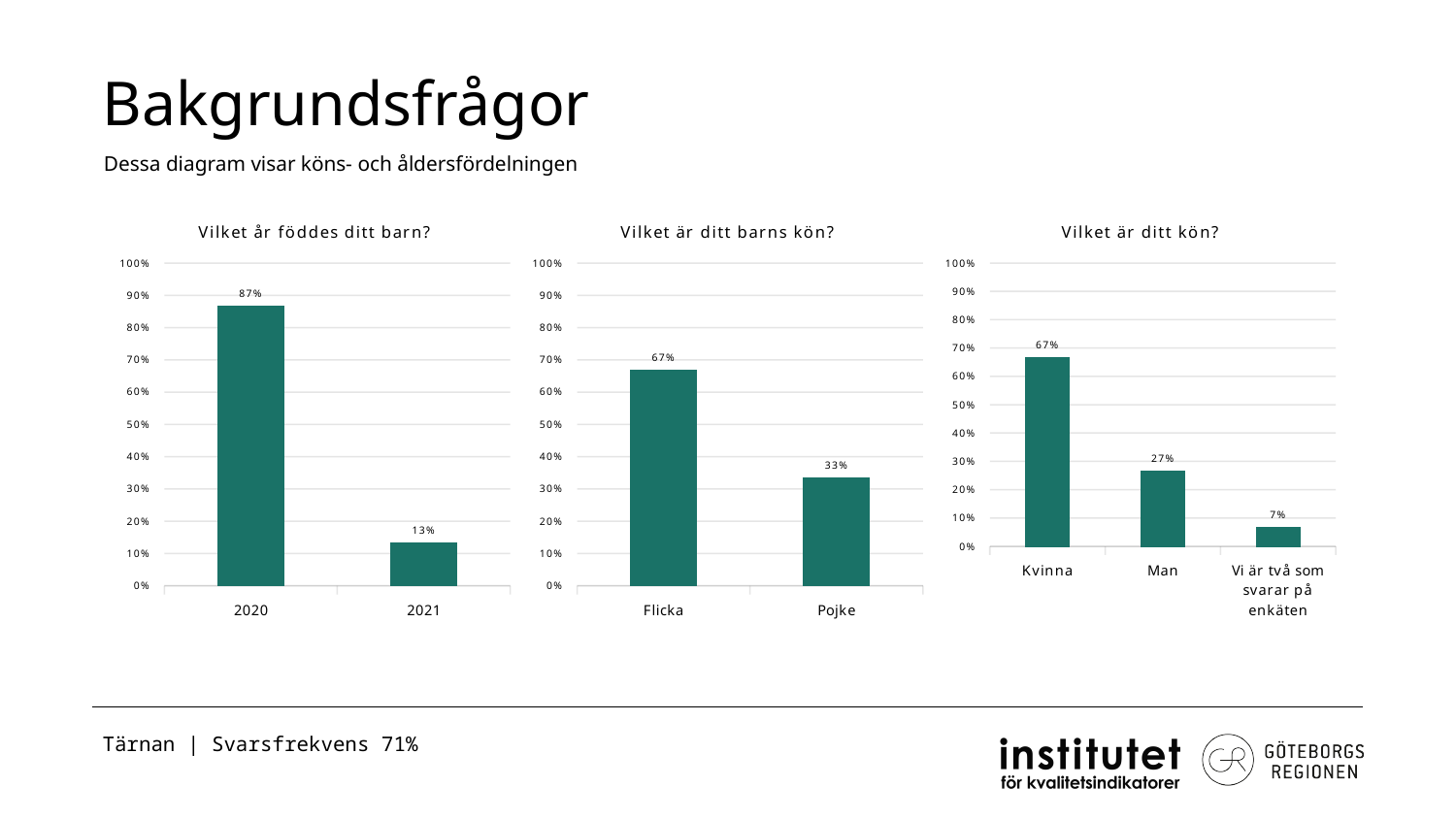
In the chart titled "Vilket är ditt barns kön?", what is the value for Flicka? 67% In the chart titled "Vilket år föddes ditt barn?", what is the value for 2021? 13% In the chart titled "Vilket är ditt kön?", which category has the lowest value? Vi är två som svarar på enkäten In the chart titled "Vilket är ditt kön?", which category has the highest value? Kvinna In the chart titled "Vilket är ditt barns kön?", what is the value for Pojke? 33% In the chart titled "Vilket år föddes ditt barn?", what is the value for 2020? 87% In the chart titled "Vilket är ditt barns kön?", which category has the higher value, Flicka or Pojke? Flicka In the chart titled "Vilket år föddes ditt barn?", what is the difference between the values for 2020 and 2021? 74% In the chart titled "Vilket är ditt kön?", what is the value for Man? 27% What kind of chart is the chart titled "Vilket år föddes ditt barn?"? Bar chart How many categories are shown in the chart titled "Vilket är ditt kön?"? 3 In the chart titled "Vilket är ditt kön?", what is the value for "Vi är två som svarar på enkäten"? 7%